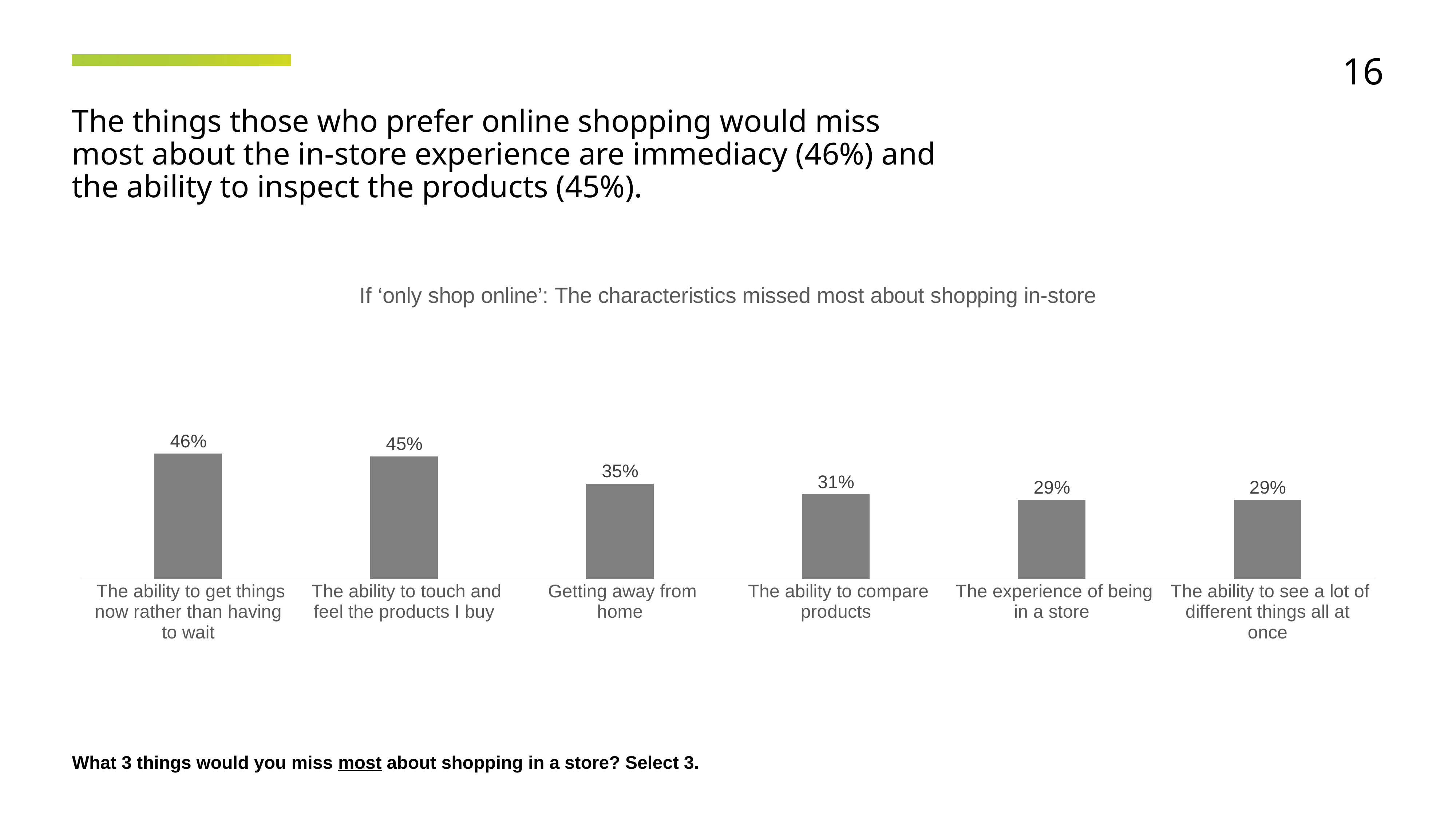
Which is larger, 'Getting away from home' or 'The experience of being in a store'? Getting away from home Do the values rise or fall from left to right across the chart? Fall What kind of chart is shown on the slide? Bar chart What is the value for 'The ability to compare products'? 31% What is the difference between 'The ability to get things now rather than having to wait' and 'Getting away from home'? 11% What value is shown for 'The experience of being in a store'? 29% Which category has the highest value? The ability to get things now rather than having to wait What is the value for 'Getting away from home'? 35% How many categories are shown in the chart? 6 What is the value for 'The ability to touch and feel the products I buy'? 45% What is the title of the chart? If 'only shop online': The characteristics missed most about shopping in-store What is the difference between 'The ability to touch and feel the products I buy' and 'The ability to compare products'? 14%